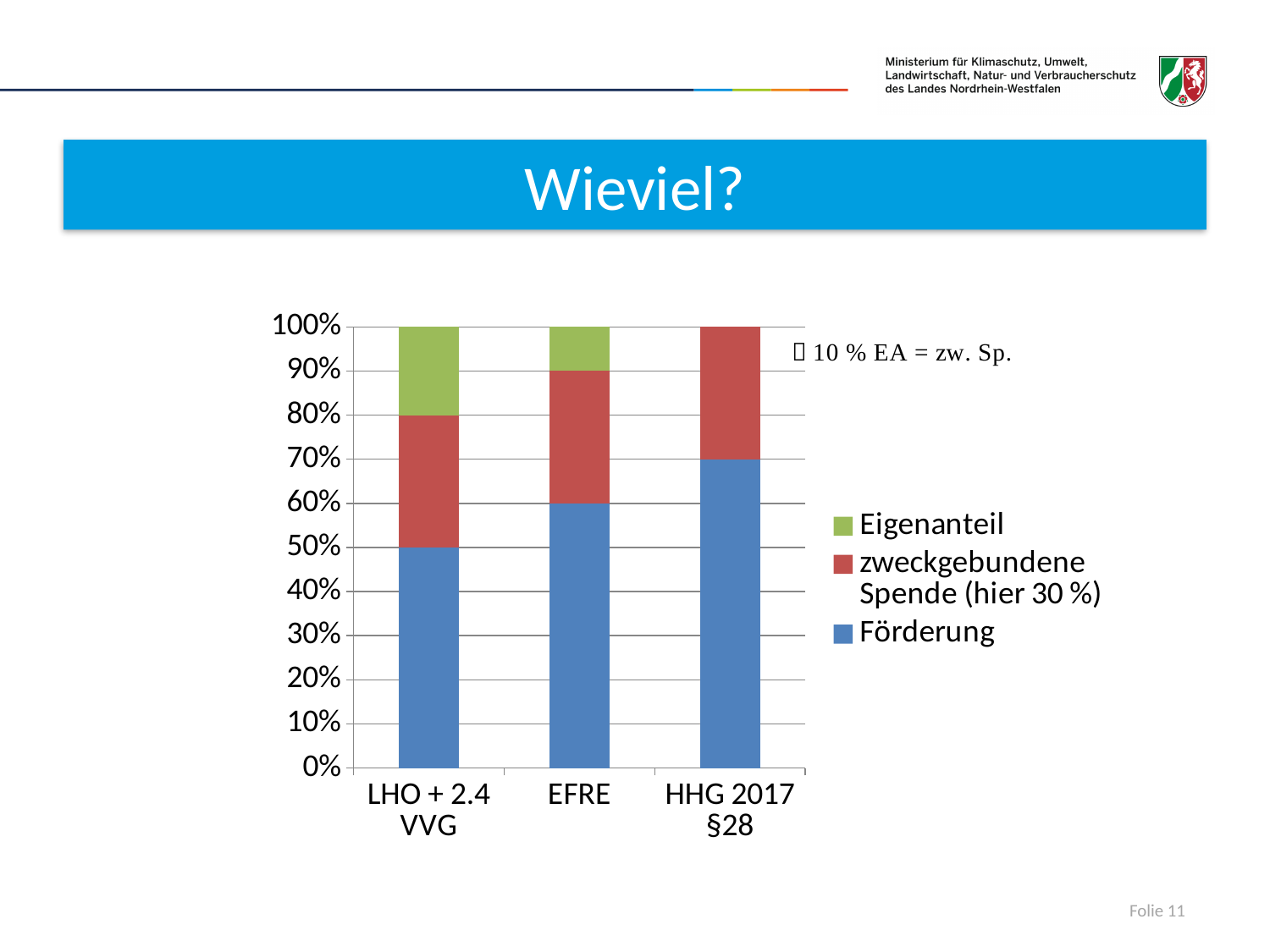
Which category has the lowest Förderung value? LHO + 2.4 VVG Is the Förderung value for EFRE larger or smaller than the Förderung value for LHO + 2.4 VVG? larger Does the Förderung value rise or fall from LHO + 2.4 VVG to HHG 2017 §28? rise How many categories are shown on the x axis of the chart? 3 What is the value of Förderung for EFRE? 60% What is the value of Förderung for LHO + 2.4 VVG? 50% Is the Eigenanteil value for LHO + 2.4 VVG greater or less than 10%? greater What kind of chart is shown on the slide? stacked bar chart Which category has the highest Förderung value? HHG 2017 §28 What is the title of the slide containing the chart? Wieviel? How many series does the chart's legend list? 3 What is the value of Förderung for HHG 2017 §28? 70%